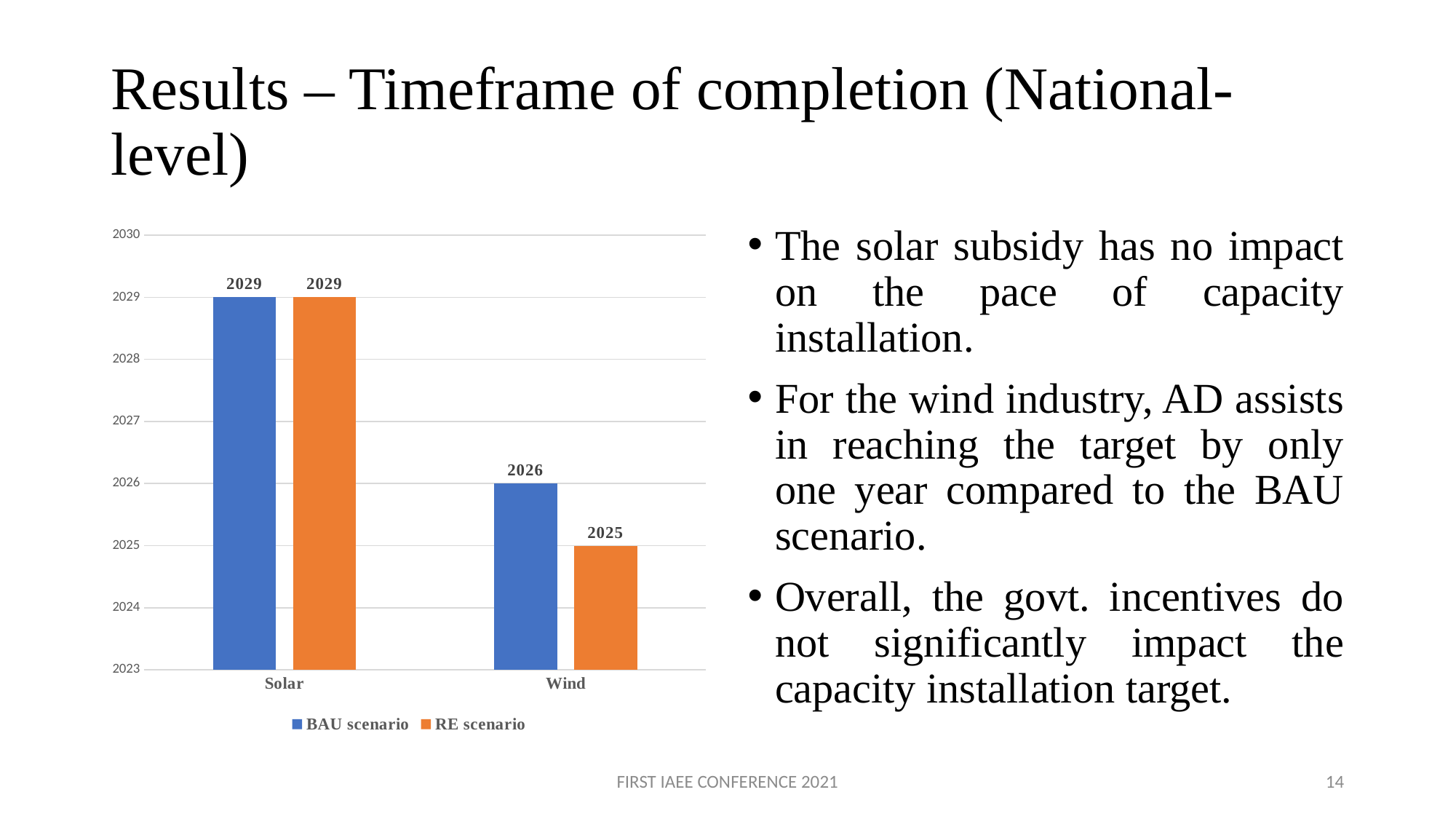
What kind of chart is shown on the slide? Bar chart How many categories are shown on the x axis? 2 How many series does the legend list? 2 What is the BAU scenario value for Wind? 2026 Which is larger for Wind, the BAU scenario value or the RE scenario value? BAU scenario Do the BAU scenario values rise or fall from Solar to Wind? Fall What is the difference between the BAU scenario and RE scenario values for Wind? 1 What is the BAU scenario value for Solar? 2029 What colour are the RE scenario bars? Orange What is the RE scenario value for Wind? 2025 What is the RE scenario value for Solar? 2029 Which category has the lowest RE scenario value? Wind